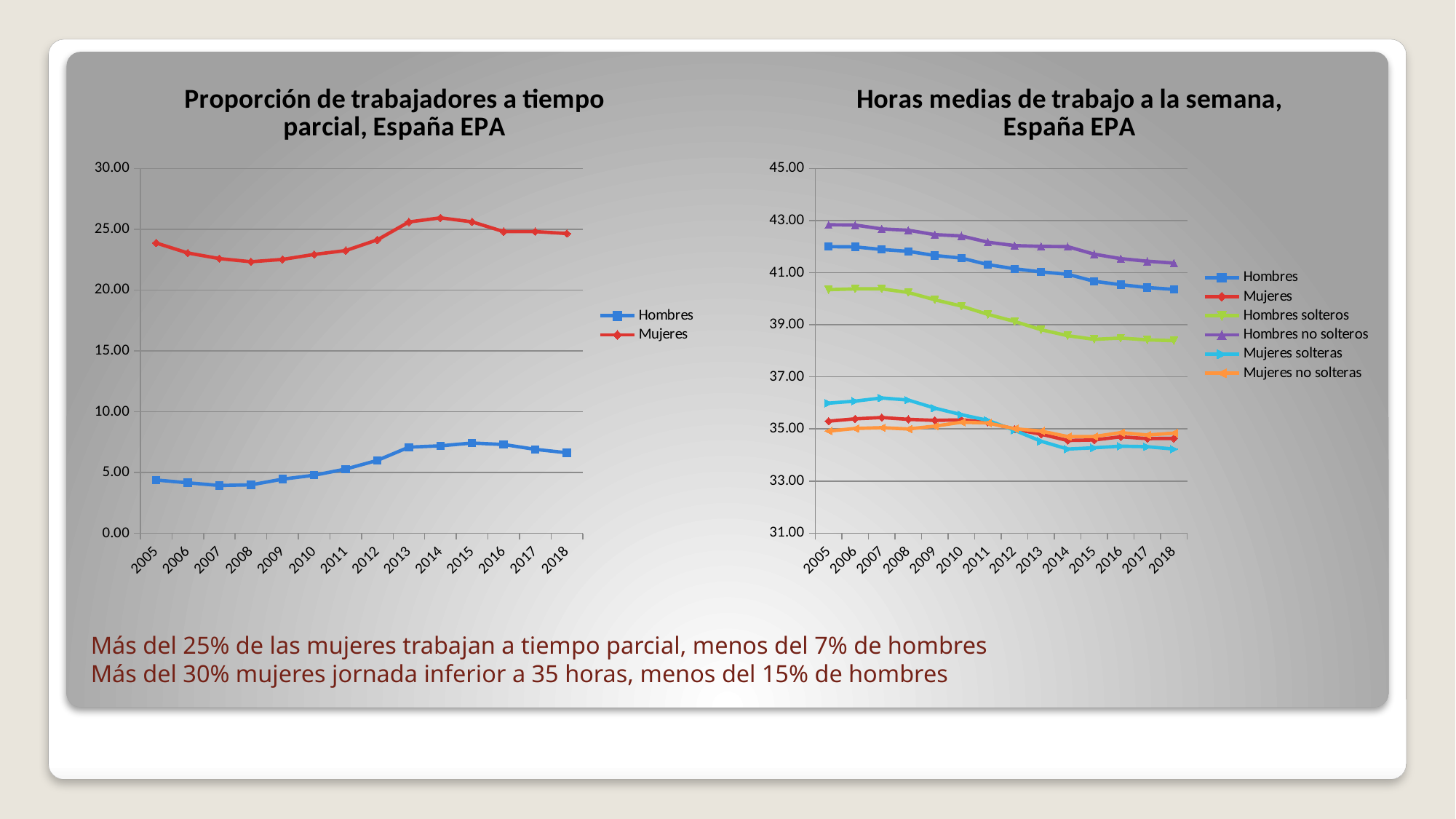
In the right chart, 'Horas medias de trabajo a la semana, España EPA', which series has the highest values across all years? Hombres no solteros In the right chart, 'Horas medias de trabajo a la semana, España EPA', what colour is the line for Mujeres no solteras? orange How many series does the legend of the right chart, 'Horas medias de trabajo a la semana, España EPA', list? 6 In the left chart, 'Proporción de trabajadores a tiempo parcial, España EPA', is the value for Hombres in 2015 greater or less than 10.00? less In the left chart, 'Proporción de trabajadores a tiempo parcial, España EPA', which series has the higher value in 2018, Hombres or Mujeres? Mujeres In the right chart, 'Horas medias de trabajo a la semana, España EPA', which series has the lowest value in 2018? Mujeres solteras How many years are plotted along the x axis of the left chart, 'Proporción de trabajadores a tiempo parcial, España EPA'? 14 In the left chart, 'Proporción de trabajadores a tiempo parcial, España EPA', in which year does the Mujeres series reach its highest value? 2014 In the right chart, 'Horas medias de trabajo a la semana, España EPA', does the Hombres series rise or fall from 2005 to 2018? fall In the left chart, 'Proporción de trabajadores a tiempo parcial, España EPA', is the value for Mujeres in 2014 greater or less than 25.00? greater In the right chart, 'Horas medias de trabajo a la semana, España EPA', is the value for Hombres solteros in 2005 greater or less than 39.00? greater What kind of chart is the left chart, 'Proporción de trabajadores a tiempo parcial, España EPA'? line chart